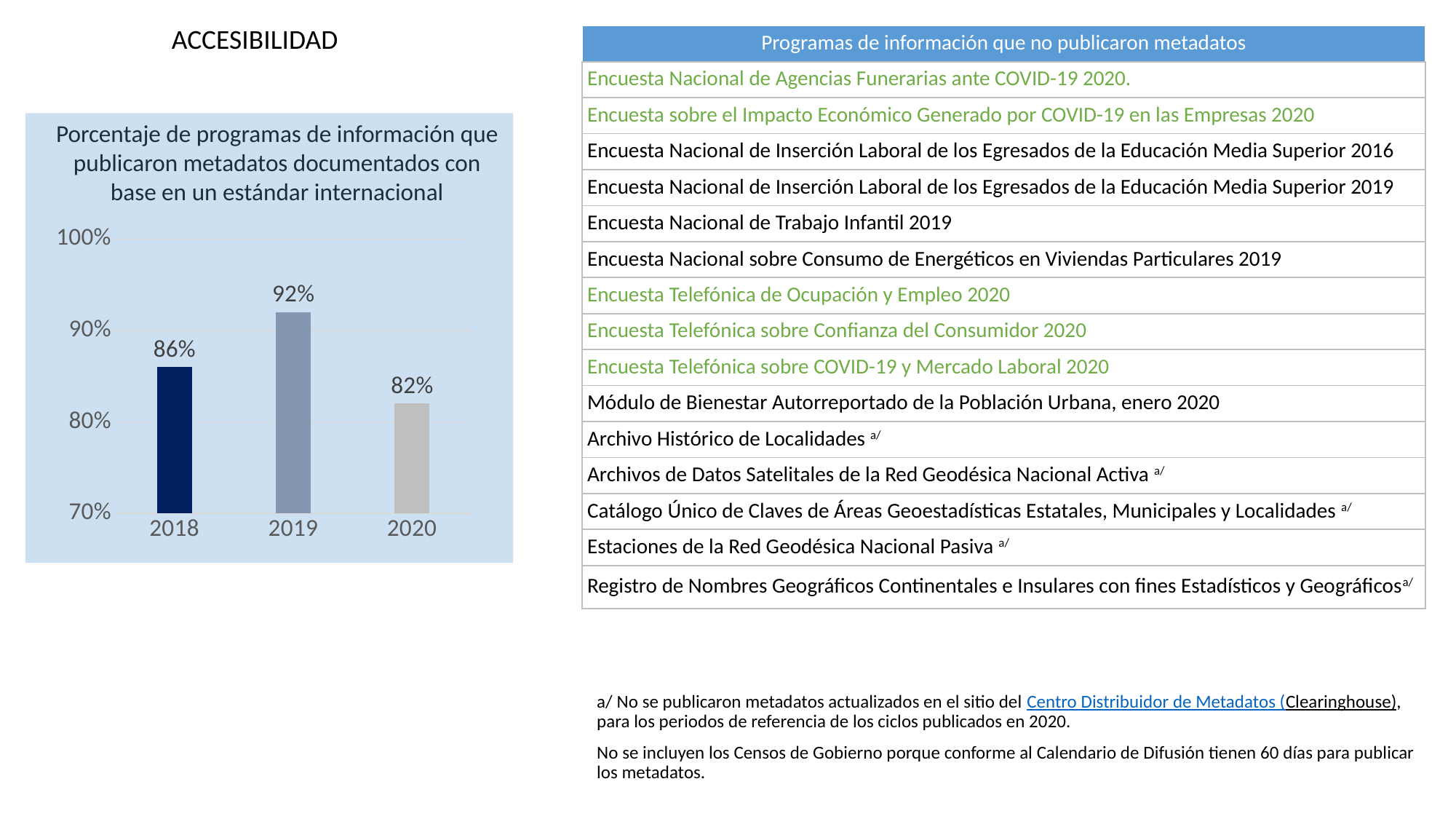
What kind of chart is shown? bar chart What is the value for 2020? 82% How many years are shown on the x axis? 3 Which is larger, the value for 2018 or the value for 2020? 2018 What is the value for 2019? 92% What is the difference between the values for 2019 and 2018? 6% Which year has the highest value? 2019 Is the value for 2019 greater or less than 90%? greater Which year has the lowest value? 2020 What is the title of the chart? Porcentaje de programas de información que publicaron metadatos documentados con base en un estándar internacional What is the value for 2018? 86% What is the difference between the values for 2019 and 2020? 10%